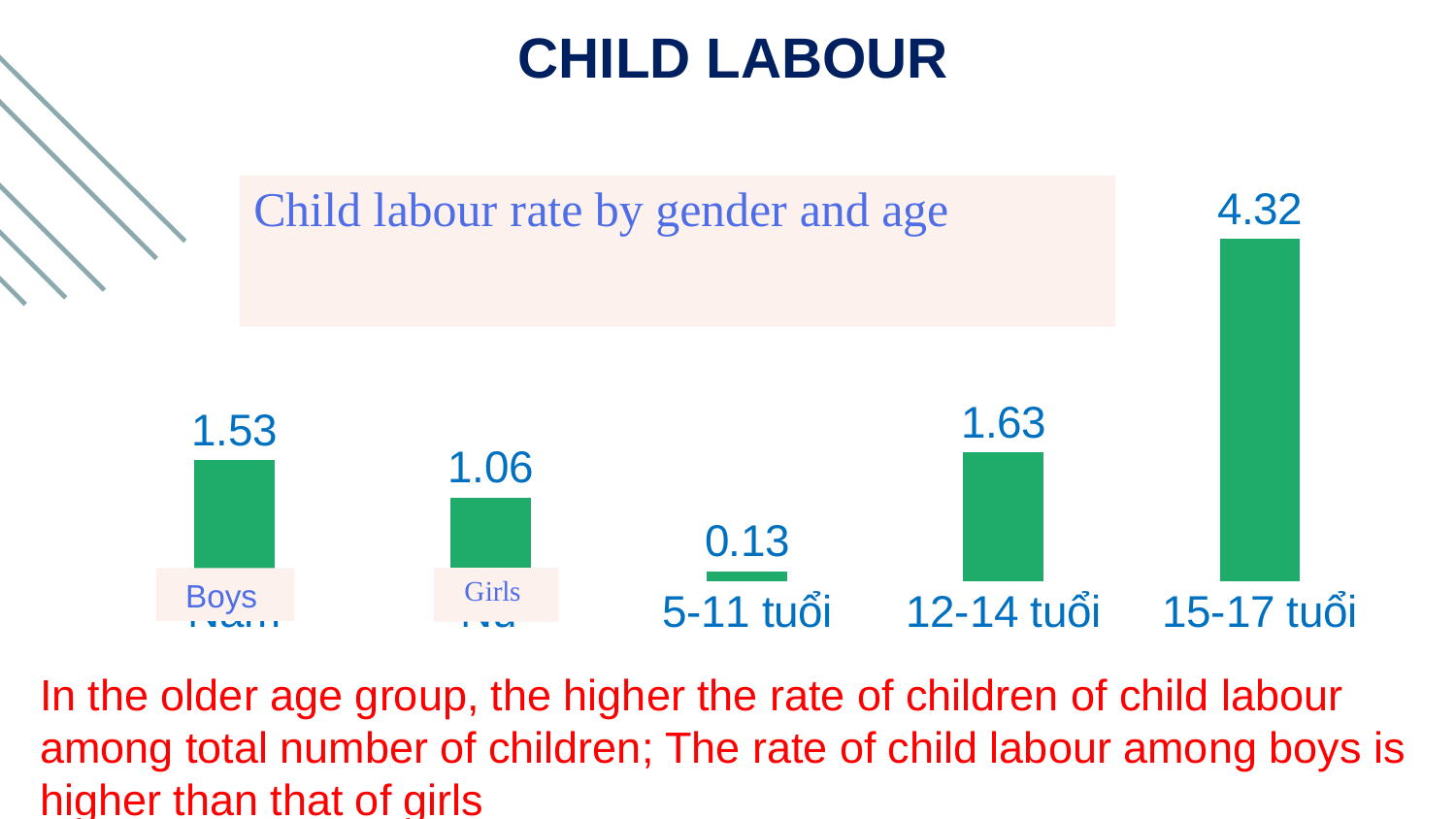
What is the difference between the child labour rate for boys and for girls? 0.47 What is the value shown for the 15-17 tuổi age group? 4.32 What is the value shown for the 5-11 tuổi age group? 0.13 What is the child labour rate for boys? 1.53 What is the child labour rate for girls? 1.06 What is the value shown for the 12-14 tuổi age group? 1.63 Which category has the lowest value in the chart? 5-11 tuổi What type of chart is shown on the slide? Bar chart Which category has the highest value in the chart? 15-17 tuổi How many bars are shown in the chart? 5 Which is larger, the value for boys or the value for the 12-14 tuổi age group? 12-14 tuổi What is the difference between the values for the 15-17 tuổi and 12-14 tuổi age groups? 2.69